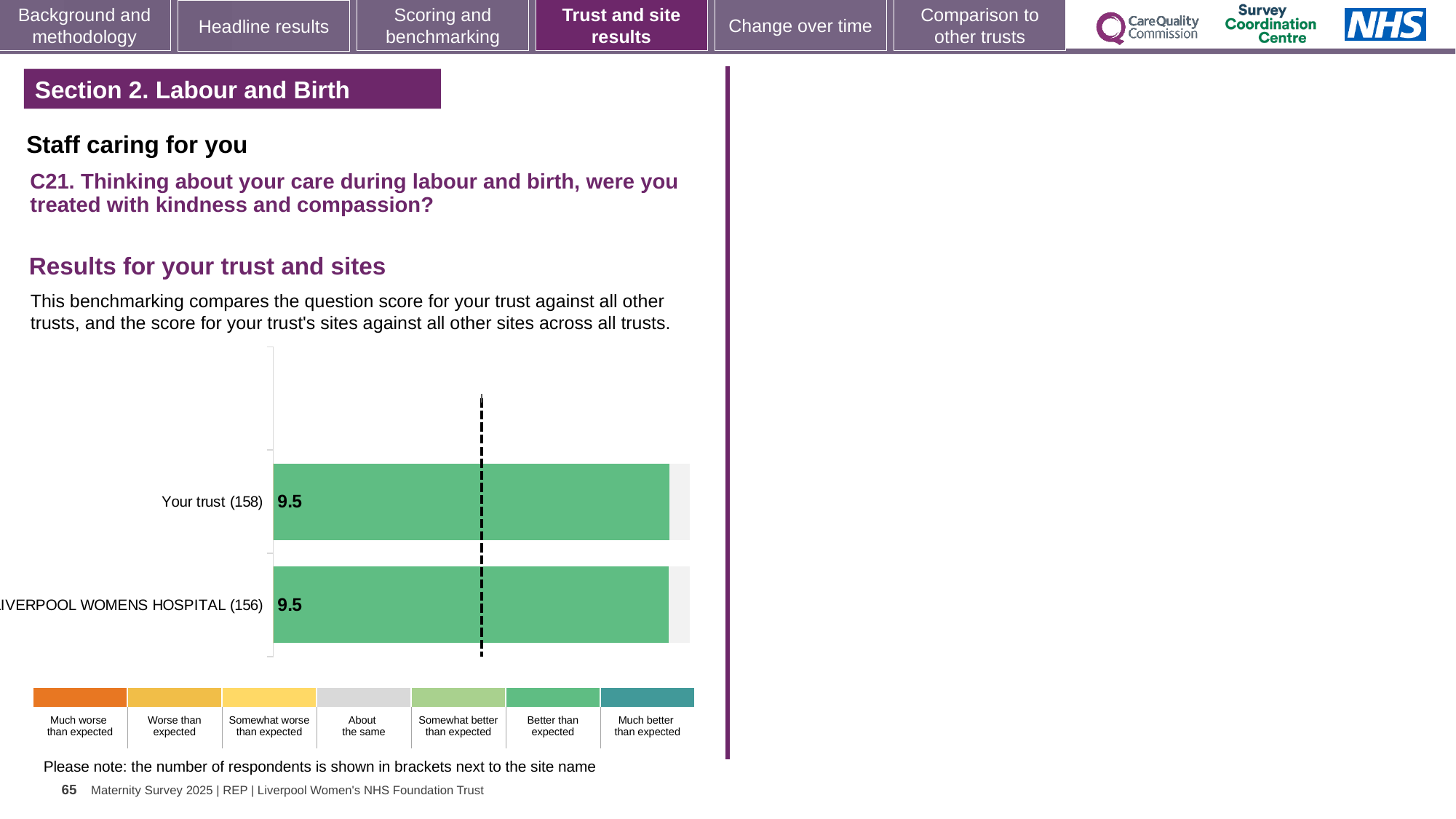
How many respondents are shown in brackets for Liverpool Womens Hospital? 156 Which rating category in the colour key does the green colour of the bars correspond to? Better than expected Is the score for Your trust greater or less than 5? greater Which survey question does the chart relate to? C21. Thinking about your care during labour and birth, were you treated with kindness and compassion? What is the score for Your trust in the chart? 9.5 How many rating categories does the colour key below the chart list? 7 What is the difference between the score for Your trust and the score for Liverpool Womens Hospital? 0.0 How many respondents are shown in brackets for Your trust? 158 What is the score for Liverpool Womens Hospital in the chart? 9.5 What kind of chart is shown on the slide? Bar chart How many bars are plotted in the chart? 2